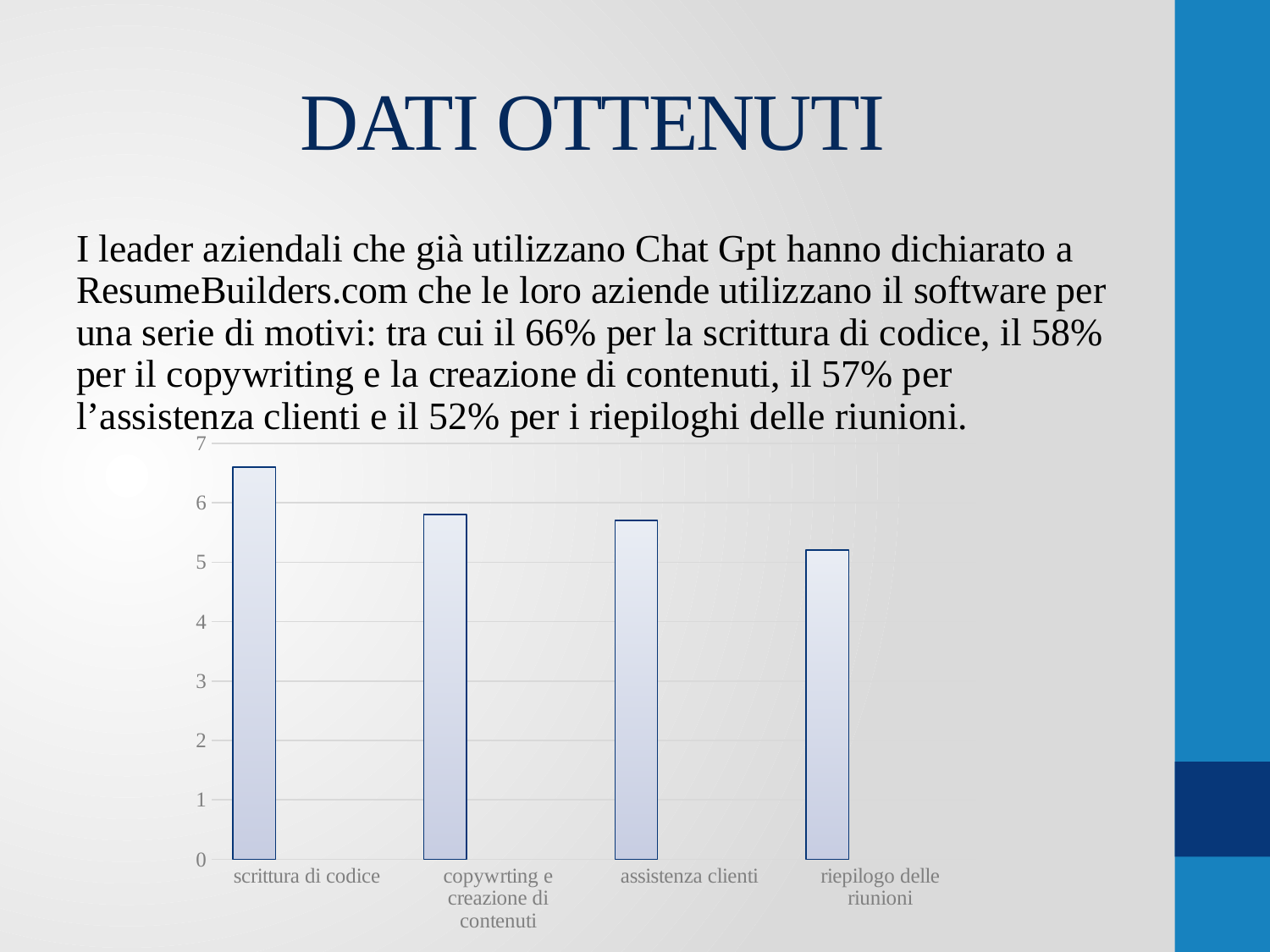
Which is larger, the bar for scrittura di codice or the bar for riepilogo delle riunioni? scrittura di codice Do the bar values rise or fall from left to right along the x axis? fall Which is larger, the bar for copywrting e creazione di contenuti or the bar for riepilogo delle riunioni? copywrting e creazione di contenuti Is the value for scrittura di codice greater or less than 6? greater Is the value for assistenza clienti greater or less than 5? greater What kind of chart is shown on the slide? bar chart Which category has the lowest bar in the chart? riepilogo delle riunioni How many categories are shown on the x axis of the chart? 4 What is the maximum value shown on the vertical axis of the chart? 7 Is the value for riepilogo delle riunioni greater or less than 6? less Which category has the highest bar in the chart? scrittura di codice